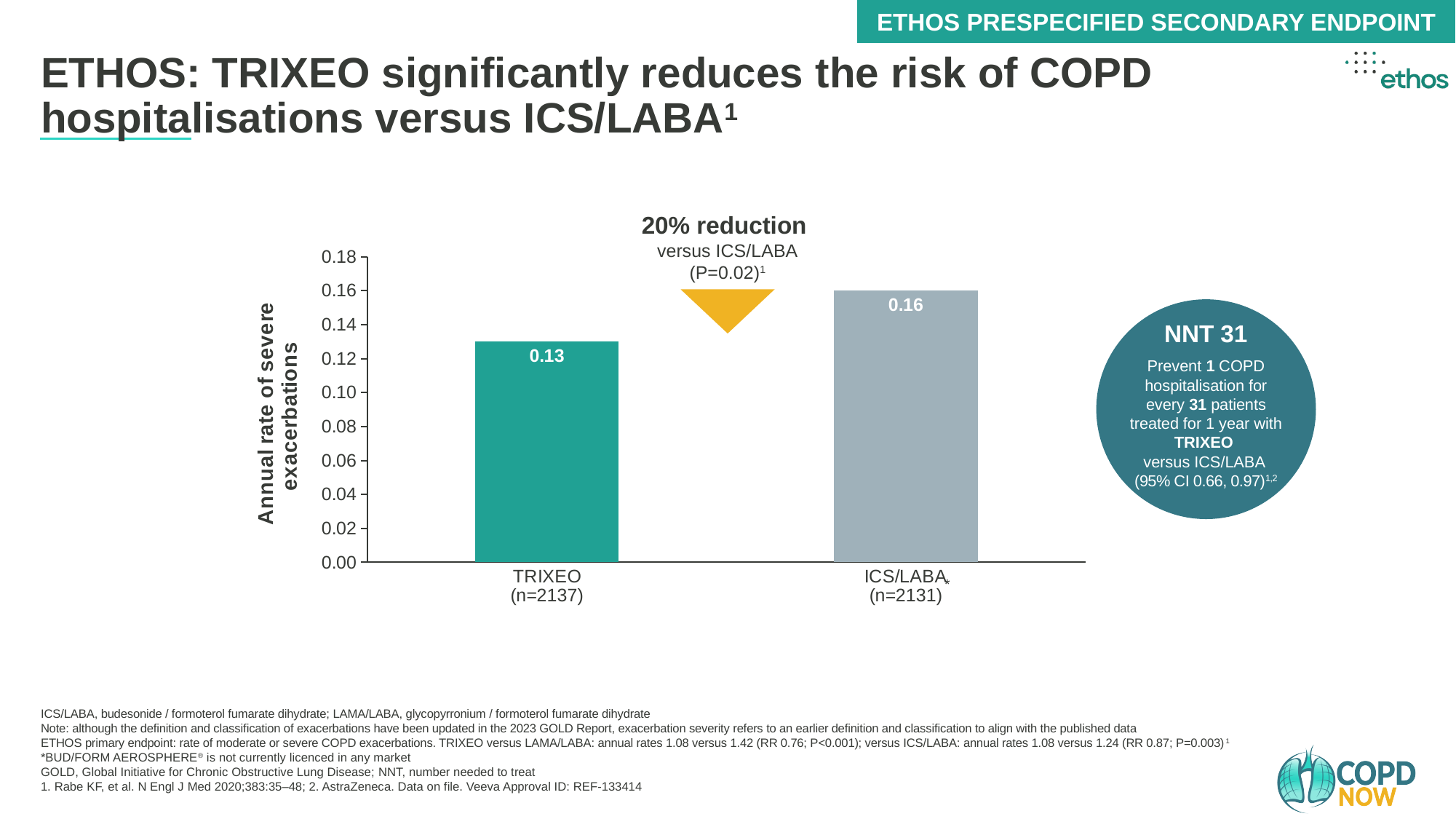
What is the annual rate of severe exacerbations for ICS/LABA? 0.16 What is the label of the y axis of the chart? Annual rate of severe exacerbations What kind of chart is shown on the slide? Bar chart How many treatment groups are plotted in the chart? 2 Which treatment group has the lower annual rate of severe exacerbations? TRIXEO What is the annual rate of severe exacerbations for TRIXEO? 0.13 What percentage reduction versus ICS/LABA is annotated above the bars? 20% reduction Is the value for TRIXEO greater or less than 0.14? less Which treatment group has the higher annual rate of severe exacerbations? ICS/LABA What is the difference in annual rate of severe exacerbations between ICS/LABA and TRIXEO? 0.03 Is the value for ICS/LABA greater or less than 0.14? greater Is the annual rate of severe exacerbations higher for TRIXEO or for ICS/LABA? ICS/LABA